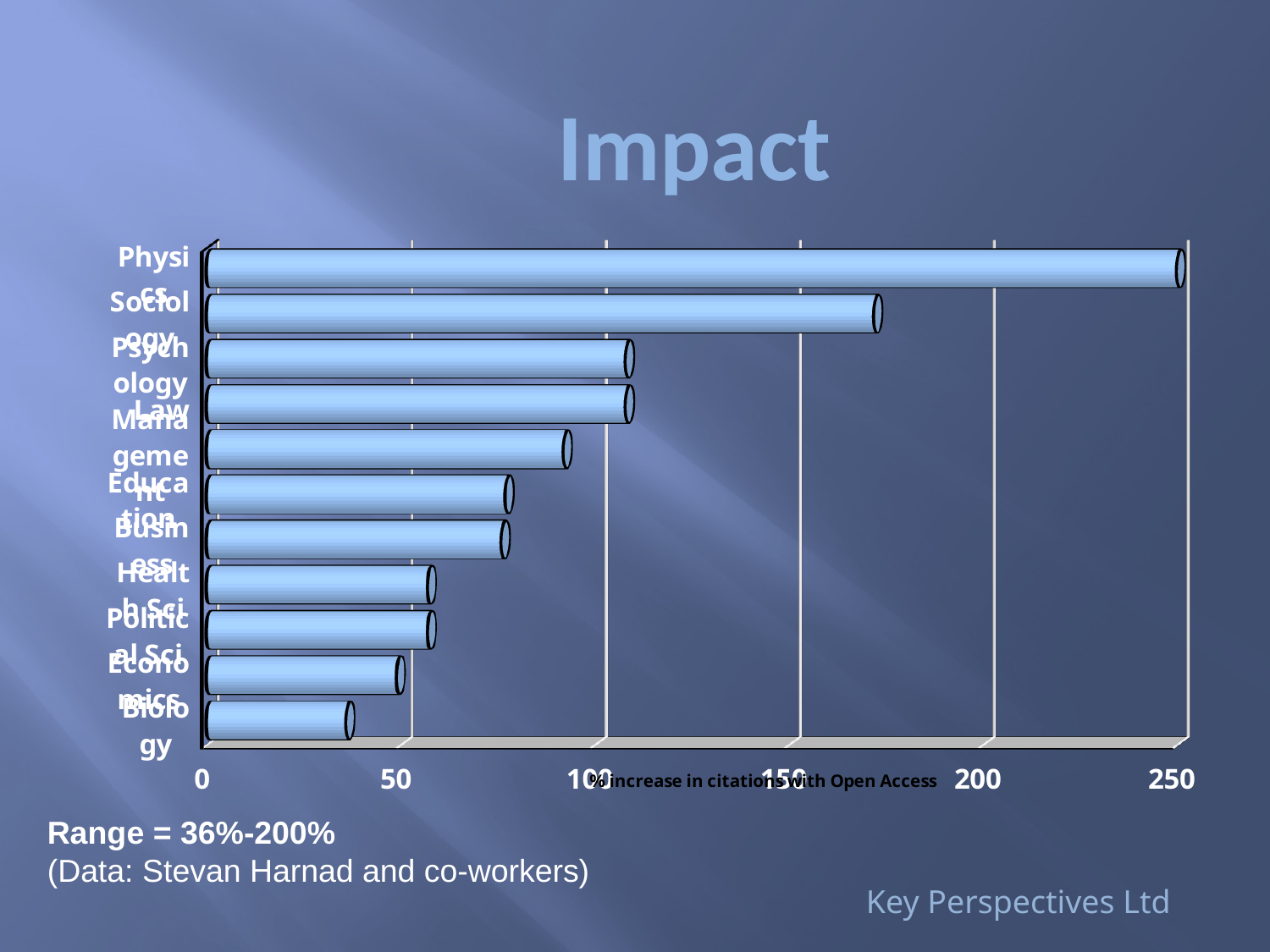
Is the value for Physics greater or less than 200? greater What is the title of the slide containing the chart? Impact How many categories (bars) does the chart show? 11 What kind of chart is shown on the slide? bar chart Which has the larger value, Sociology or Law? Sociology Is the value for Sociology greater or less than 150? greater What is the label on the horizontal axis of the chart? % increase in citations with Open Access Which category has the lowest value in the chart? Biology Which category has the highest value in the chart? Physics Which has the larger value, Economics or Education? Education Is the value for Management greater or less than 100? less